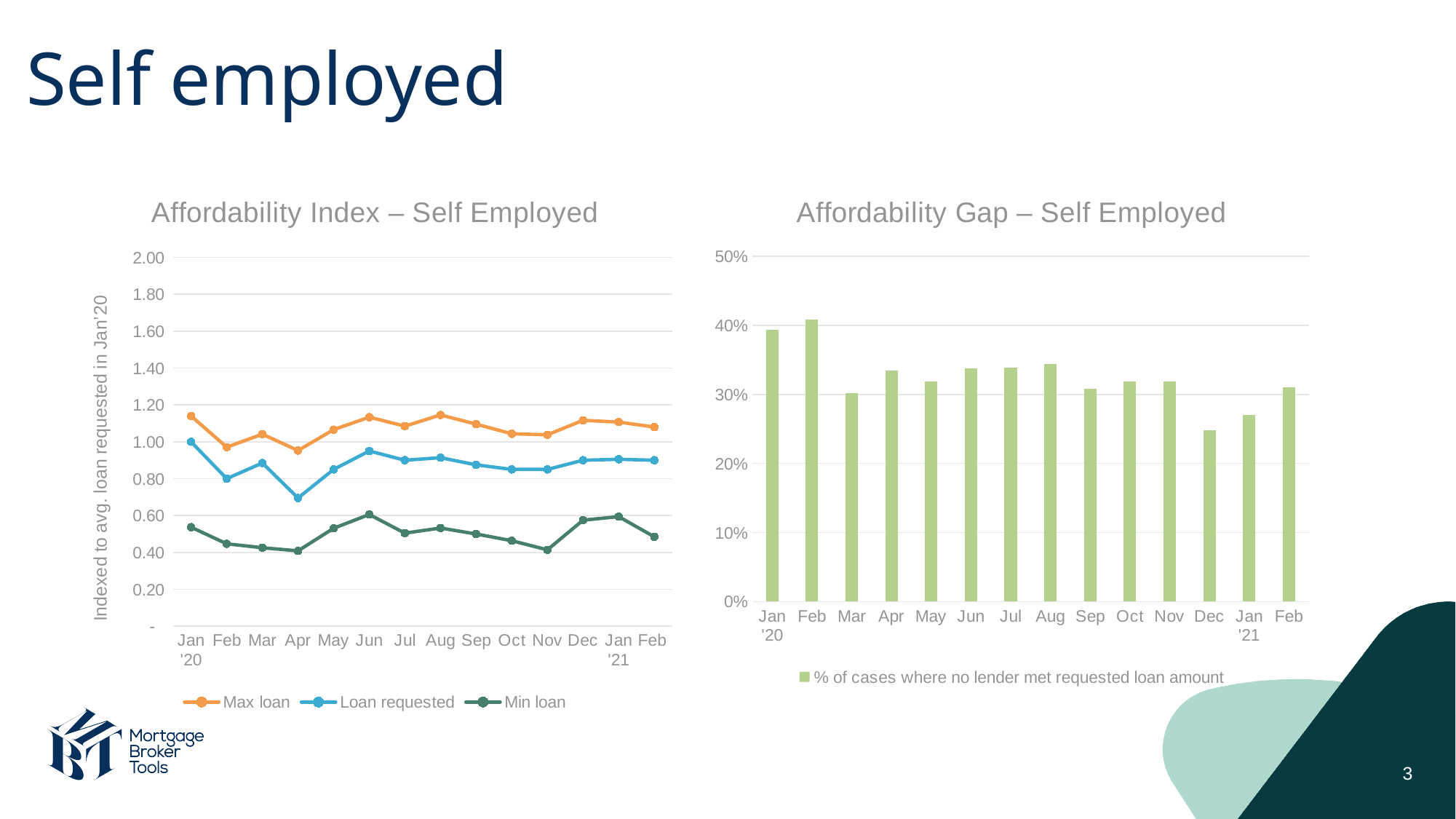
In the 'Affordability Gap – Self Employed' chart, is the value for Feb '20 greater or less than 40%? greater How many series does the legend of the 'Affordability Index – Self Employed' chart list? 3 In the 'Affordability Index – Self Employed' chart, is the 'Loan requested' value for Apr greater or less than 0.80? less In the 'Affordability Gap – Self Employed' chart, which month has the lowest bar? Dec In the 'Affordability Gap – Self Employed' chart, which month has the highest bar? Feb '20 What kind of chart is the 'Affordability Gap – Self Employed' chart? bar chart In the 'Affordability Index – Self Employed' chart, in which month is the 'Loan requested' series at its lowest? Apr What is the legend entry of the 'Affordability Gap – Self Employed' chart? % of cases where no lender met requested loan amount How many bars are plotted in the 'Affordability Gap – Self Employed' chart? 14 In the 'Affordability Gap – Self Employed' chart, which is larger, the value for Jan '20 or the value for Dec? Jan '20 In the 'Affordability Gap – Self Employed' chart, is the value for Dec greater or less than 30%? less What kind of chart is the 'Affordability Index – Self Employed' chart? line chart